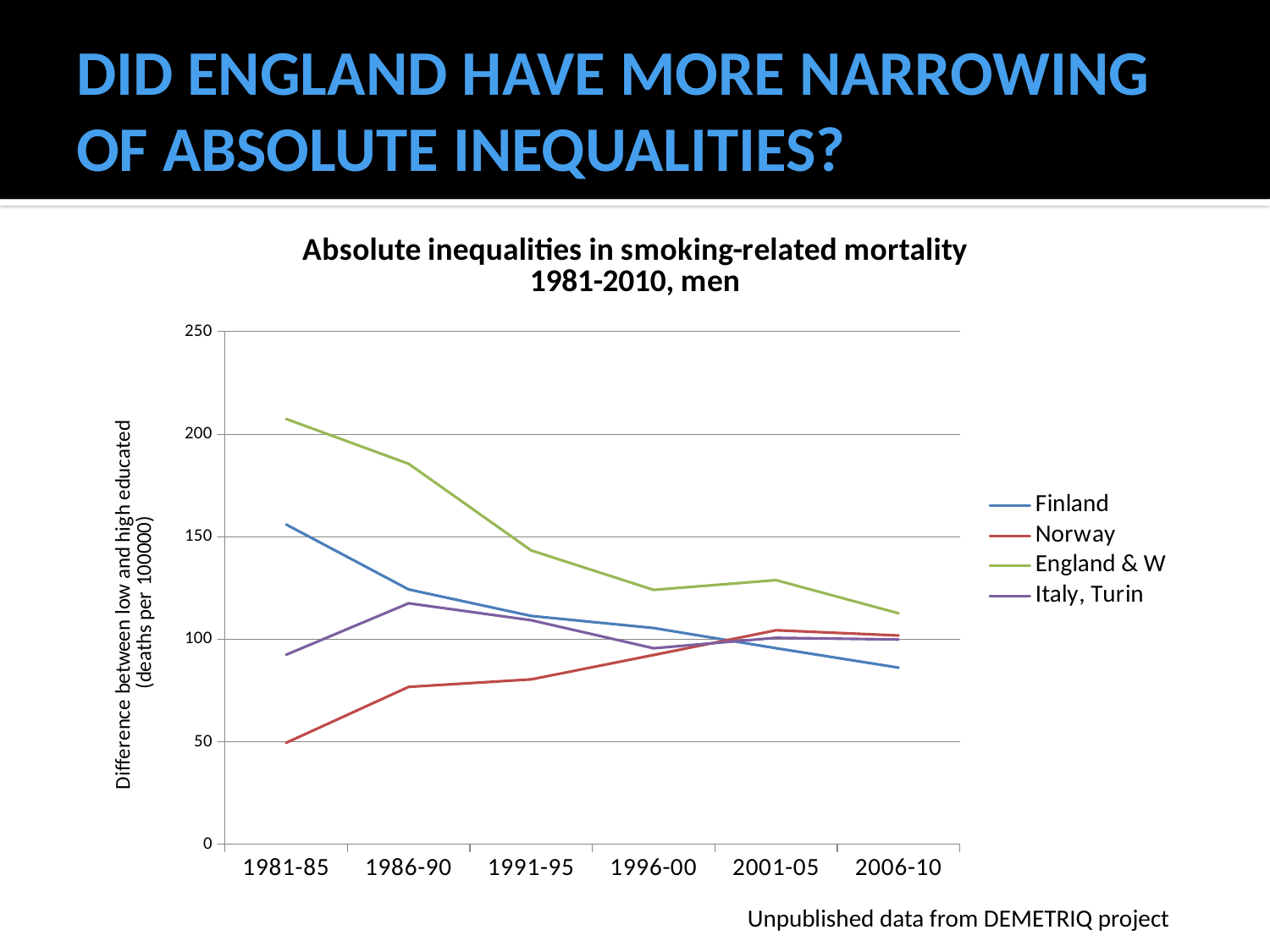
Does the England & W line rise or fall from 1981-85 to 2006-10? fall How many series does the legend list? 4 Which series has the lowest value in 1981-85? Norway How many time periods are shown on the x axis? 6 In 2006-10, which is larger: the value for Finland or the value for England & W? England & W Is the value for Norway in 1981-85 greater or less than 100? less Does the Norway line rise or fall from 1981-85 to 2006-10? rise What kind of chart is shown on the slide? line chart Is the value for England & W in 1981-85 greater or less than 150? greater Which series has the highest value in 1981-85? England & W Is the value for Finland in 2006-10 greater or less than 100? less What is the source noted below the chart? Unpublished data from DEMETRIQ project